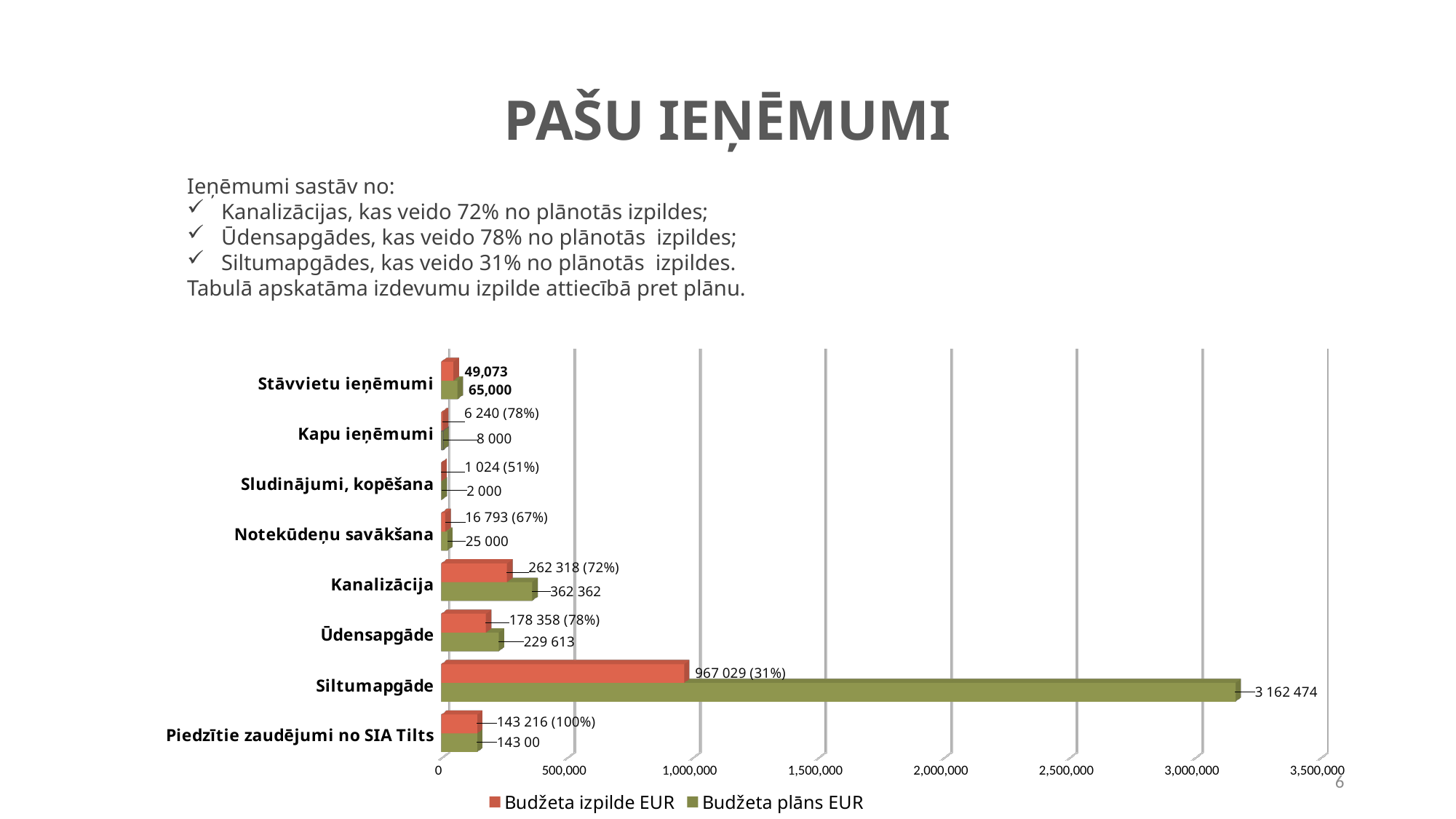
Is the Budžeta plāns EUR value for Siltumapgāde greater or less than 3,000,000? greater How many categories are shown on the chart? 8 Which is larger for Ūdensapgāde: the Budžeta plāns EUR value or the Budžeta izpilde EUR value? Budžeta plāns EUR How many series does the legend list? 2 What is the Budžeta izpilde EUR value for Kanalizācija? 262 318 (72%) What kind of chart is shown on the slide? bar chart What is the Budžeta izpilde EUR value for Stāvvietu ieņēmumi? 49,073 What is the Budžeta plāns EUR value for Ūdensapgāde? 229 613 Which category has the highest Budžeta plāns EUR value? Siltumapgāde Which category has the lowest Budžeta izpilde EUR value? Sludinājumi, kopēšana What is the Budžeta plāns EUR value for Siltumapgāde? 3 162 474 What is the difference between the Budžeta plāns EUR and Budžeta izpilde EUR values for Kanalizācija? 100 044